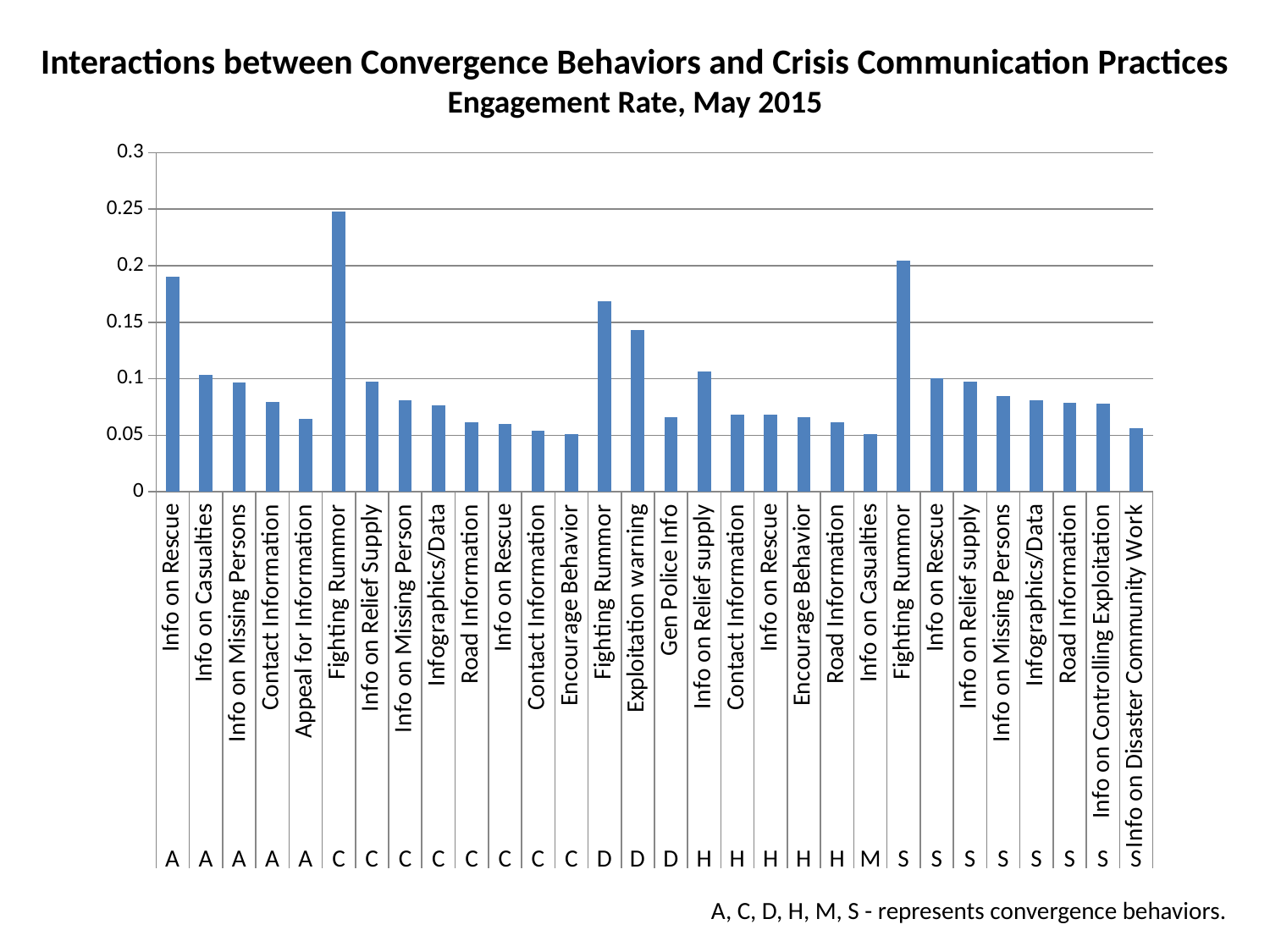
Is the value for Info on Disaster Community Work under convergence behavior S greater or less than 0.1? less Is the value for Info on Rescue under convergence behavior A greater or less than 0.15? greater Is the value for Fighting Rummor under convergence behavior D greater or less than 0.15? greater Which is larger: Info on Rescue under A or Info on Rescue under C? Info on Rescue under A Which bar has the highest engagement rate? Fighting Rummor (C) What is the subtitle of the chart? Engagement Rate, May 2015 How many bars are plotted in the chart? 30 Which is larger: Fighting Rummor under C or Fighting Rummor under D? Fighting Rummor under C What kind of chart is shown on the slide? bar chart